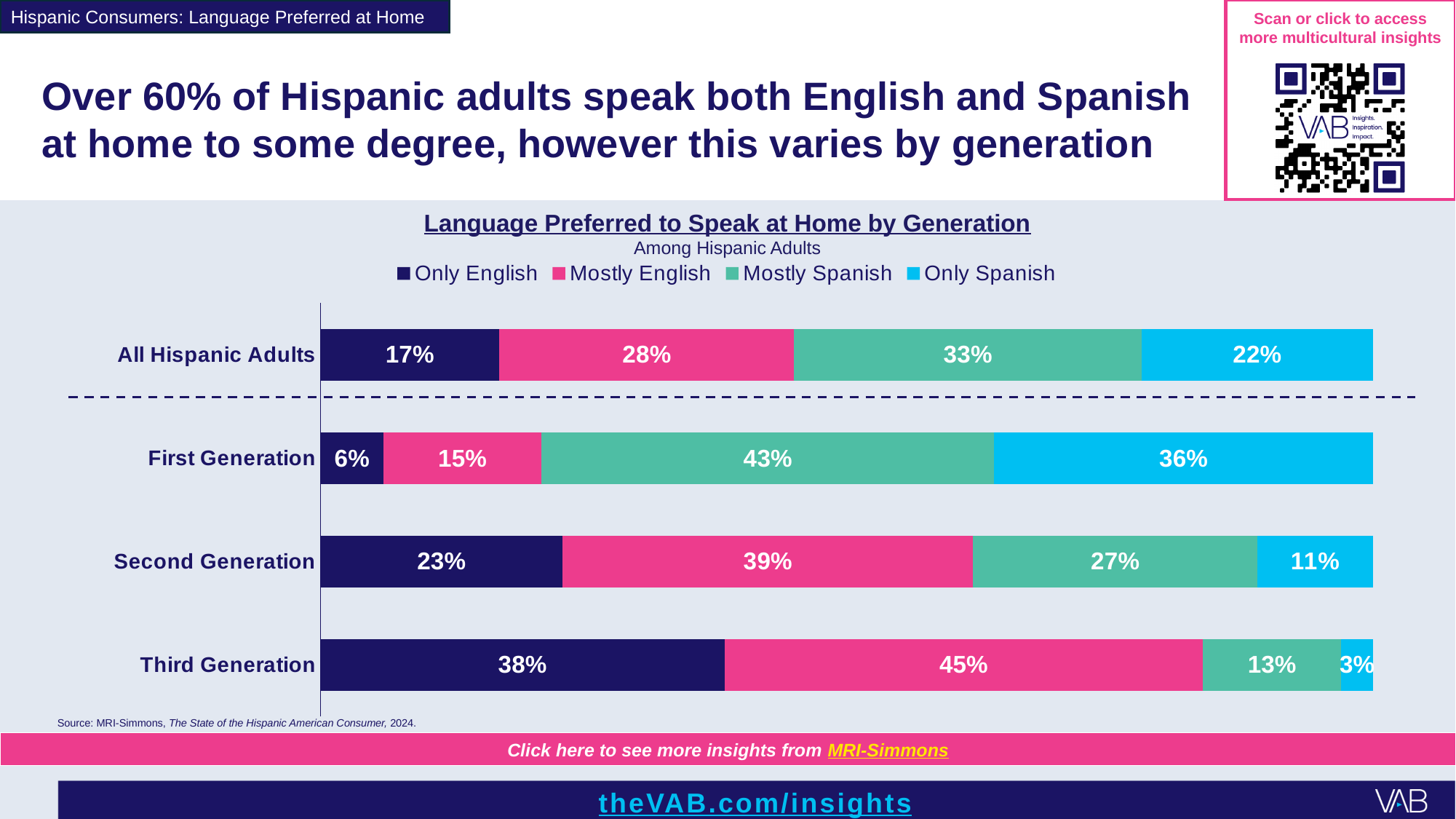
Which is larger for Second Generation: Mostly English or Mostly Spanish? Mostly English Which category has the lowest Only Spanish share? Third Generation How many series does the legend list? 4 What is the title of the chart? Language Preferred to Speak at Home by Generation What percentage of All Hispanic Adults prefer Only English at home? 17% What is the Mostly Spanish value for First Generation? 43% How many categories (bars) are shown in the chart? 4 Which generation has the highest Only English share? Third Generation What is the Mostly English value for Second Generation? 39% What is the difference between the Only Spanish values for First Generation and Second Generation? 25% What is the Only Spanish value for Third Generation? 3% What kind of chart is shown on the slide? Stacked bar chart